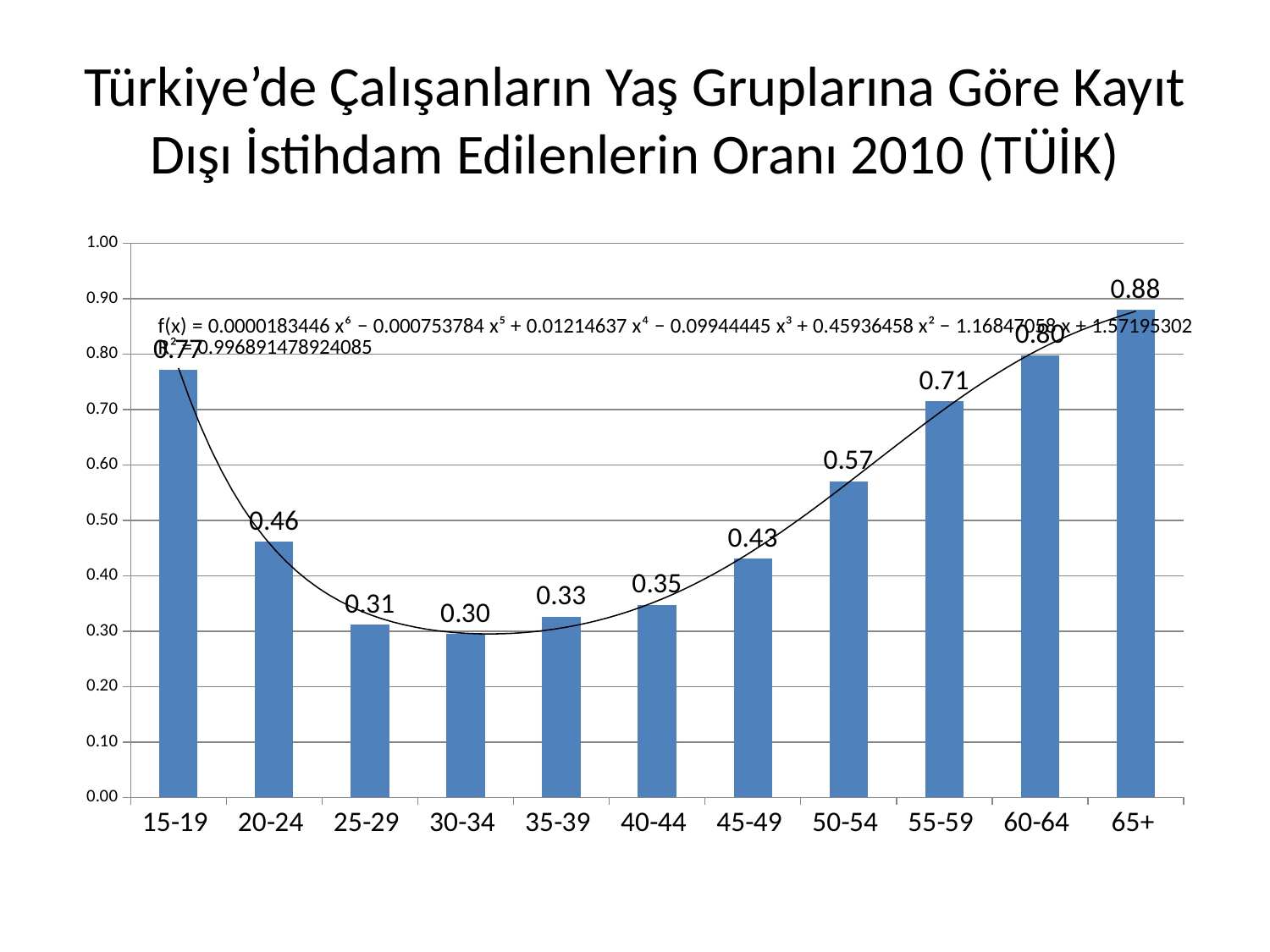
Do the values rise or fall from the 30-34 group to the 65+ group? rise What kind of chart is this? bar chart Is the value for 60-64 greater or less than 0.70? greater Which age group has the highest value? 65+ What is the value for the 30-34 age group? 0.30 What is the difference between the values for 65+ and 15-19? 0.11 What is the value for the 55-59 age group? 0.71 How many age groups are shown on the x axis? 11 What is the difference between the values for 50-54 and 45-49? 0.14 Which age group has the lowest value? 30-34 What is the value for the 15-19 age group? 0.77 Which is larger, the value for 20-24 or the value for 45-49? 20-24